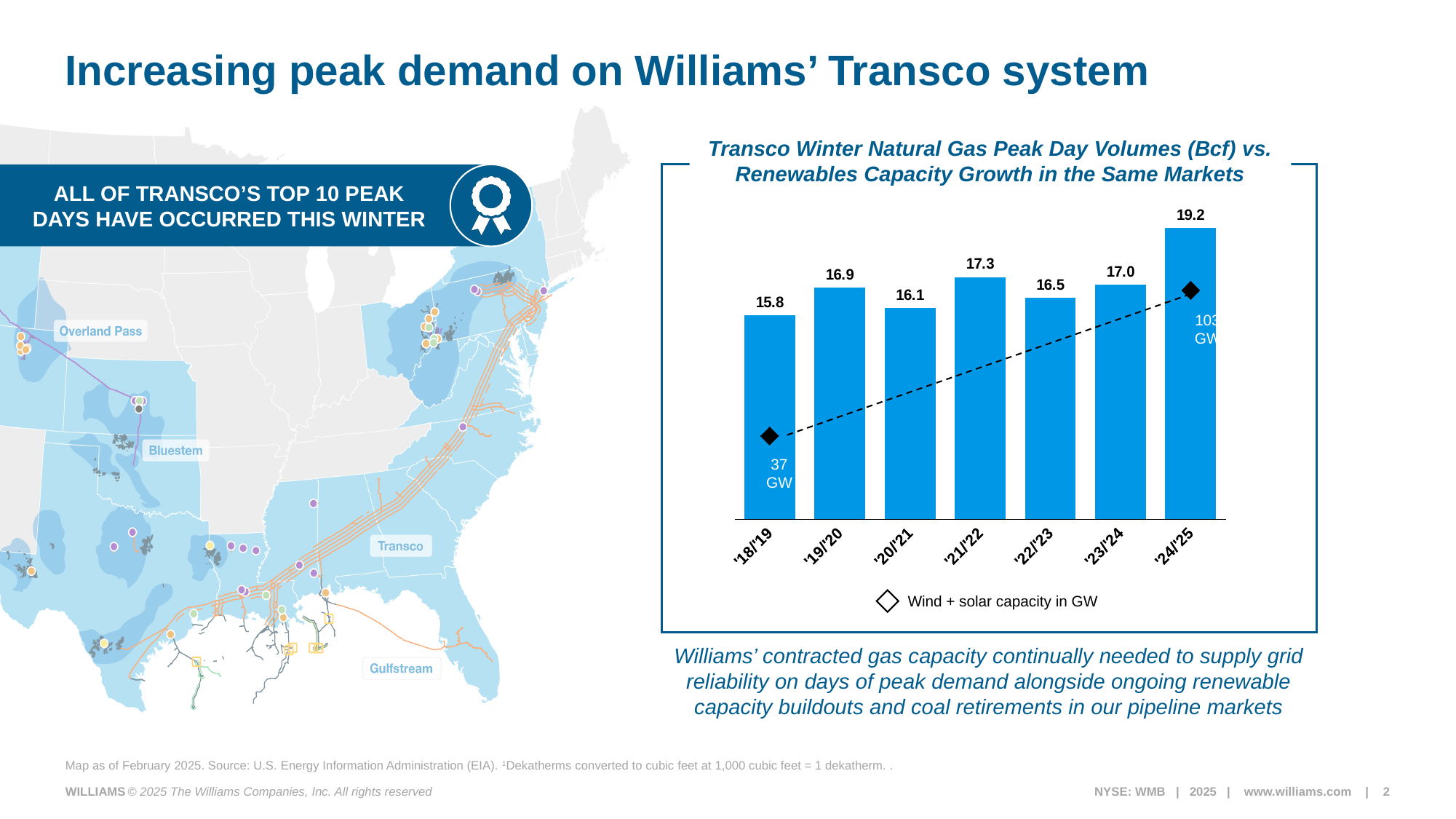
What is the Transco winter peak day volume for '24/'25? 19.2 Which is larger, the peak day volume for '19/'20 or for '20/'21? '19/'20 What is the difference in peak day volume between '24/'25 and '18/'19? 3.4 What is the Transco winter peak day volume for '21/'22? 17.3 What is the wind + solar capacity shown for '18/'19? 37 GW Which winter has the lowest peak day volume? '18/'19 What is the wind + solar capacity shown for '24/'25? 103 GW Which winter has the highest peak day volume? '24/'25 What kind of chart is used to show the peak day volumes? Bar chart What does the diamond marker in the legend represent? Wind + solar capacity in GW How many winter seasons are shown on the x axis? 7 What is the Transco winter peak day volume for '18/'19? 15.8